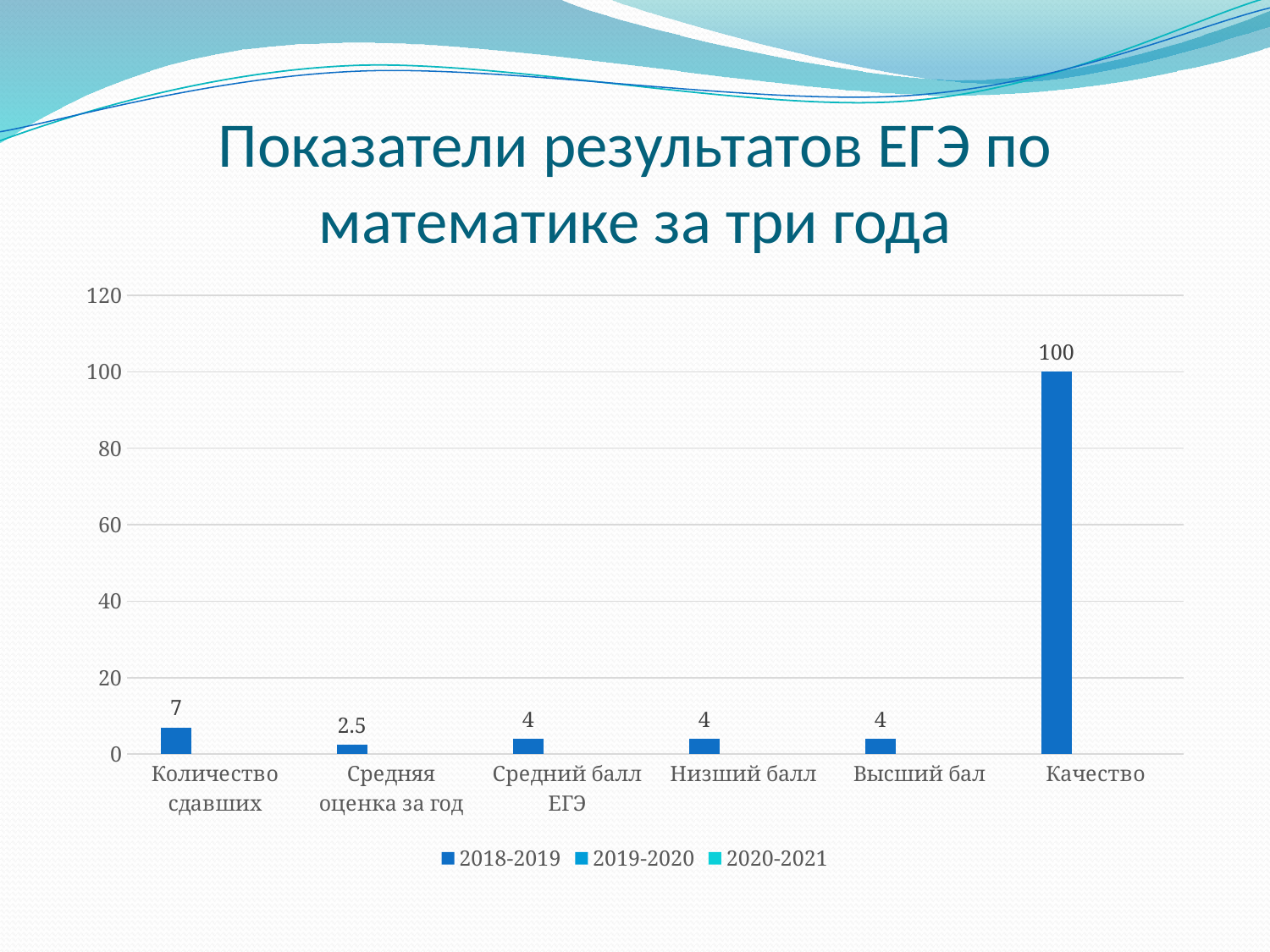
Which is larger, the value for Количество сдавших or the value for Высший бал? Количество сдавших What is the value for Средний балл ЕГЭ in the 2018-2019 series? 4 What is the title of the chart on the slide? Показатели результатов ЕГЭ по математике за три года How many categories are shown on the x axis of the chart? 6 What is the value for Средняя оценка за год in the 2018-2019 series? 2.5 How many series does the legend list? 3 Which category has the lowest value in the chart? Средняя оценка за год Which category has the highest value in the chart? Качество What is the value for Качество in the 2018-2019 series? 100 What is the value for Количество сдавших in the 2018-2019 series? 7 What is the difference between the values for Качество and Количество сдавших? 93 What kind of chart is shown on the slide? bar chart